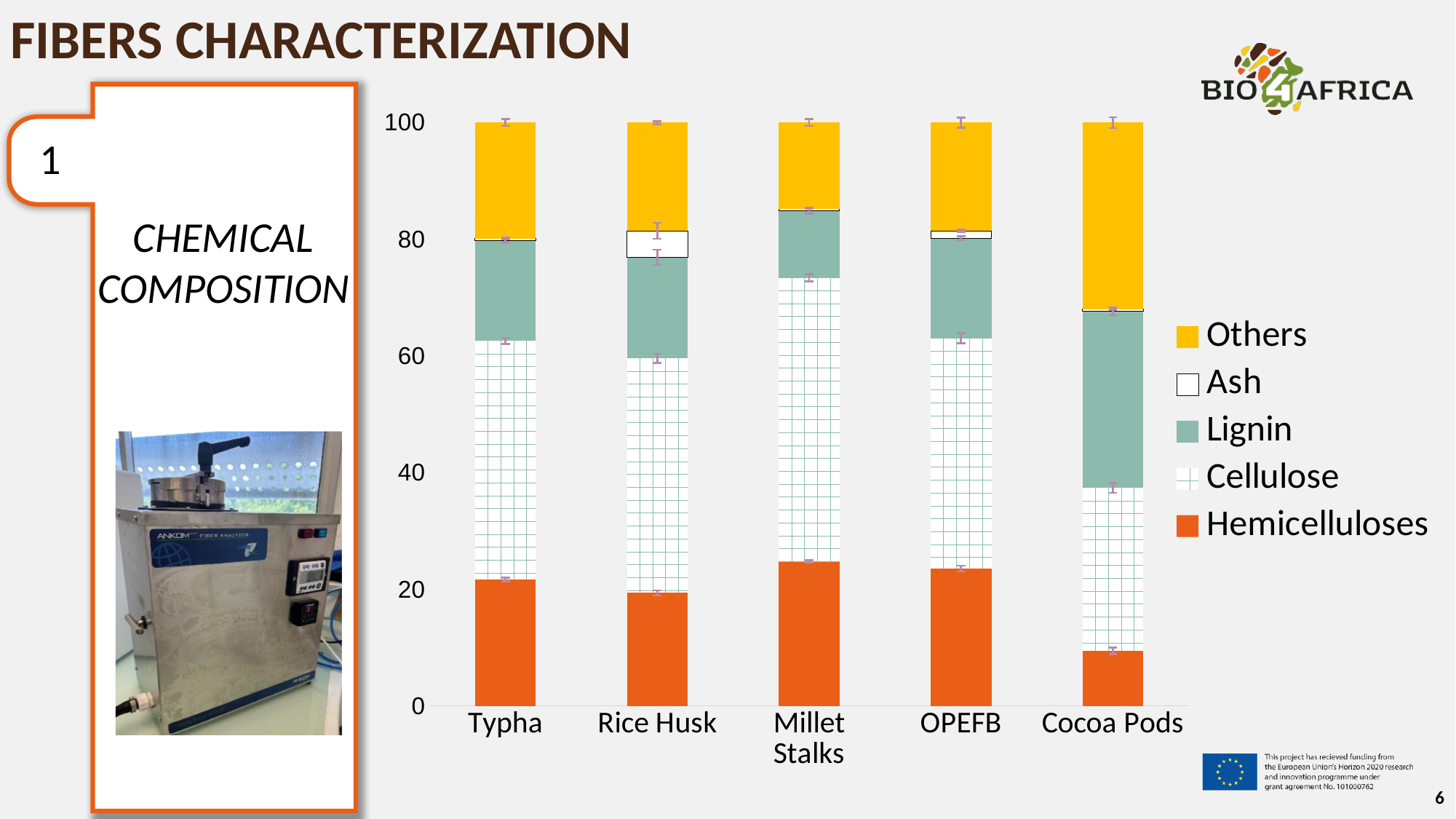
Which fiber has the largest Cellulose segment? Millet Stalks Which series is plotted at the bottom of each stacked bar? Hemicelluloses How many series does the chart legend list? 5 Is the Hemicelluloses value for Millet Stalks greater or less than 20? greater What kind of chart is shown on the slide? Stacked bar chart Which fiber has the largest Lignin segment? Cocoa Pods What is the total height of the stacked bar for Typha? 100 Which fiber has the lowest Hemicelluloses value? Cocoa Pods Which fiber has the largest Others segment? Cocoa Pods Which has the larger Hemicelluloses value, Typha or Cocoa Pods? Typha How many fiber types (categories) are shown on the x axis of the chart? 5 Is the Hemicelluloses value for Cocoa Pods greater or less than 20? less